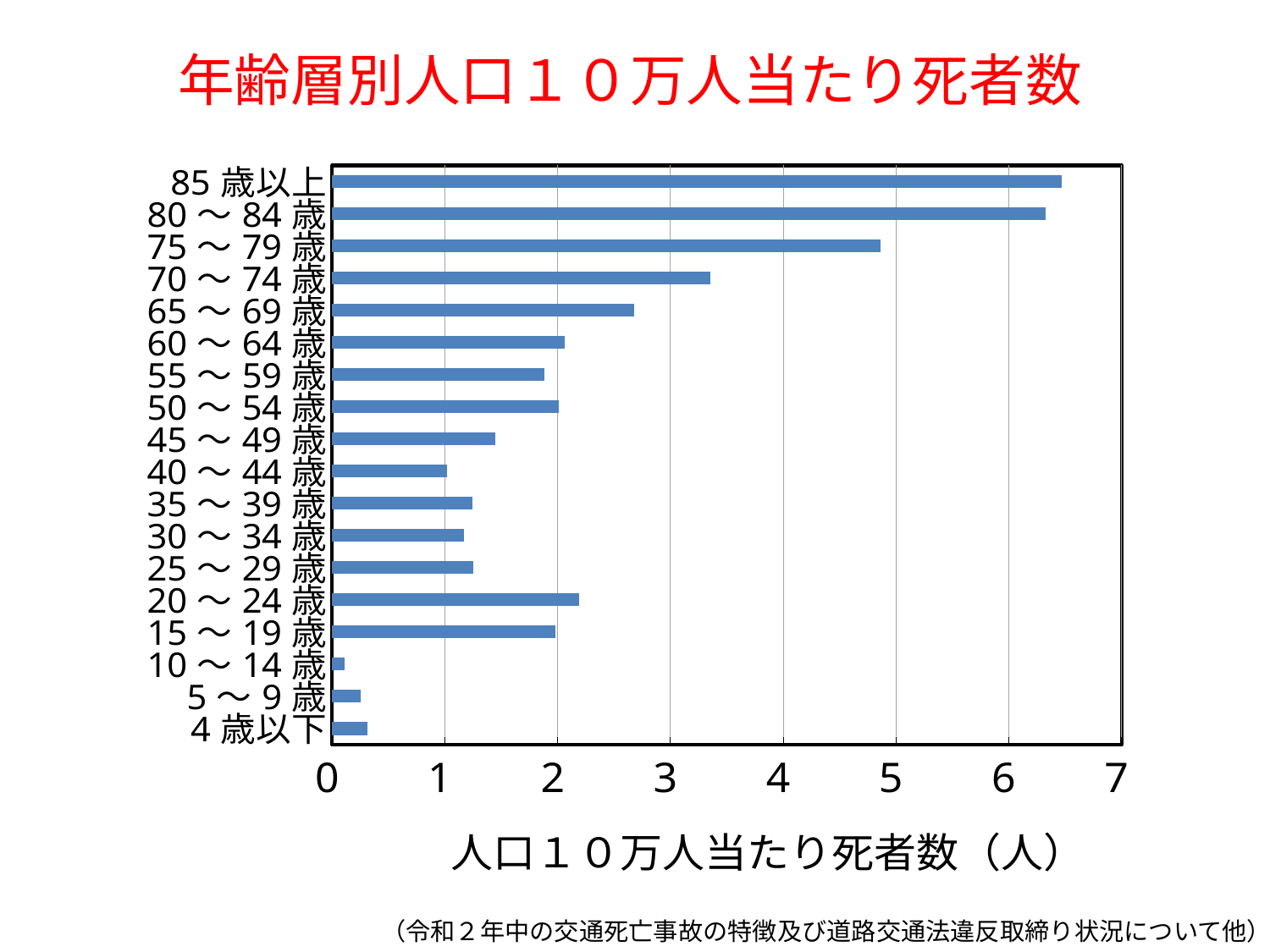
Which age group has the lowest number of deaths per 100,000 population? 10～14歳 What is the label of the horizontal axis? 人口１０万人当たり死者数（人） Is the value for 10～14歳 greater or less than 1? less Which has the larger value, 65～69歳 or 60～64歳? 65～69歳 What is the title of the chart? 年齢層別人口１０万人当たり死者数 Is the value for 75～79歳 greater or less than 4? greater Which has the larger value, 75～79歳 or 70～74歳? 75～79歳 Is the value for 45～49歳 greater or less than 2? less How many age-group categories are plotted in the chart? 18 What kind of chart is shown on the slide? Bar chart